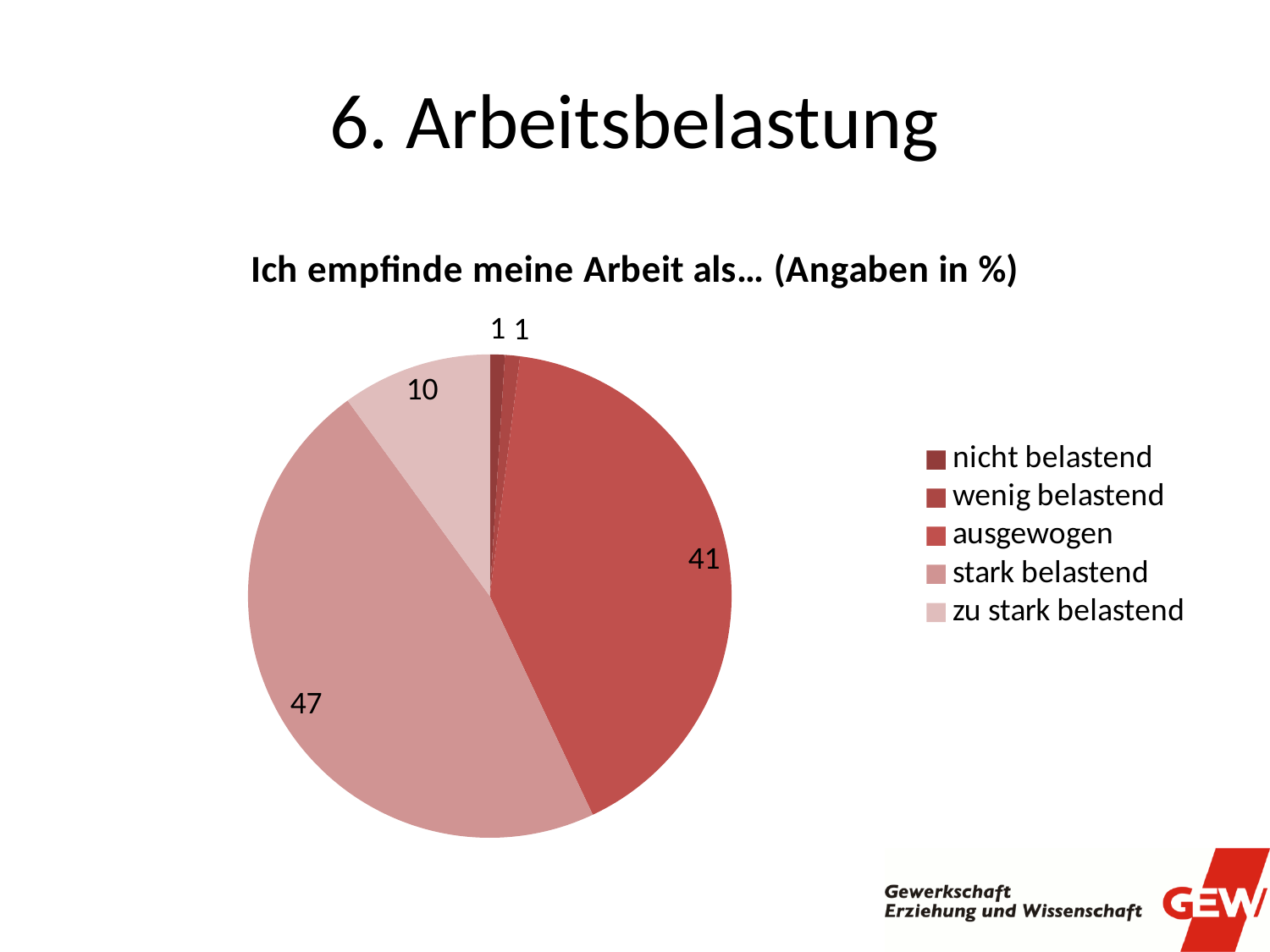
Which is larger, the value for "ausgewogen" or the value for "zu stark belastend"? ausgewogen What is the difference between the values for "zu stark belastend" and "wenig belastend"? 9 What is the difference between the values for "stark belastend" and "ausgewogen"? 6 How many categories does the legend list? 5 What is the value for "stark belastend"? 47 Which legend entry is shown in the lightest shade? zu stark belastend What is the value for "ausgewogen"? 41 Which category has the largest slice of the pie? stark belastend What is the title of the chart? Ich empfinde meine Arbeit als… (Angaben in %) What kind of chart is shown on the slide? pie chart What is the value for "zu stark belastend"? 10 What is the value for "nicht belastend"? 1